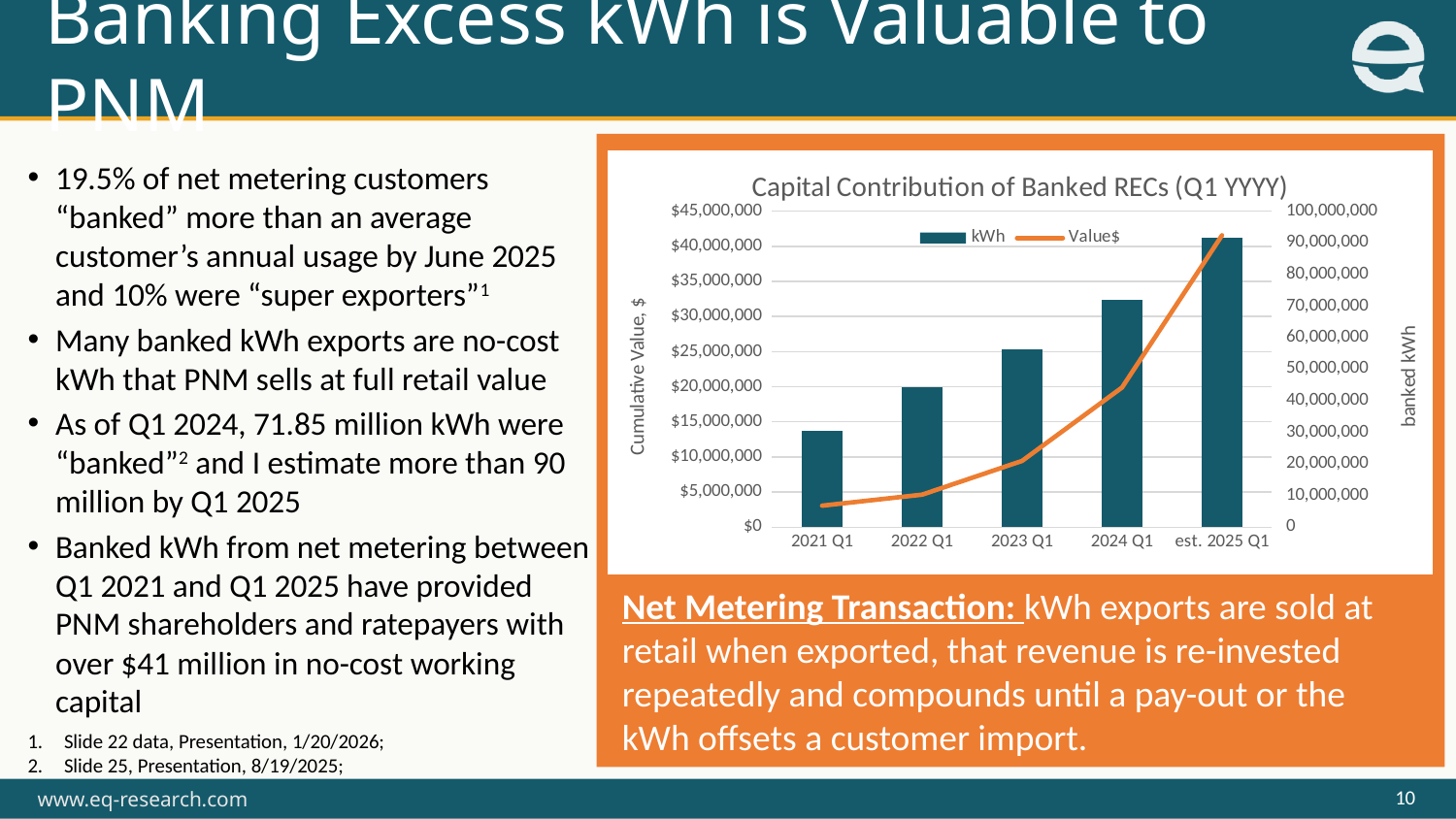
Do the kWh bars rise or fall from 2021 Q1 to est. 2025 Q1? Rise How many series does the chart's legend list? 2 Is the banked kWh value for 2021 Q1 greater or less than 40,000,000? less Which category has the shortest kWh bar in the chart? 2021 Q1 What is the title of the chart on the slide? Capital Contribution of Banked RECs (Q1 YYYY) What kind of chart is shown on the slide? A combined bar and line chart Is the banked kWh value for 2024 Q1 greater or less than 60,000,000? greater Which category has the tallest kWh bar in the chart? est. 2025 Q1 Is the Value$ for est. 2025 Q1 greater or less than $35,000,000? greater Which has the larger Value$ in the chart, 2023 Q1 or 2024 Q1? 2024 Q1 What is the label of the left vertical axis of the chart? Cumulative Value, $ How many categories are shown along the x axis of the chart? 5